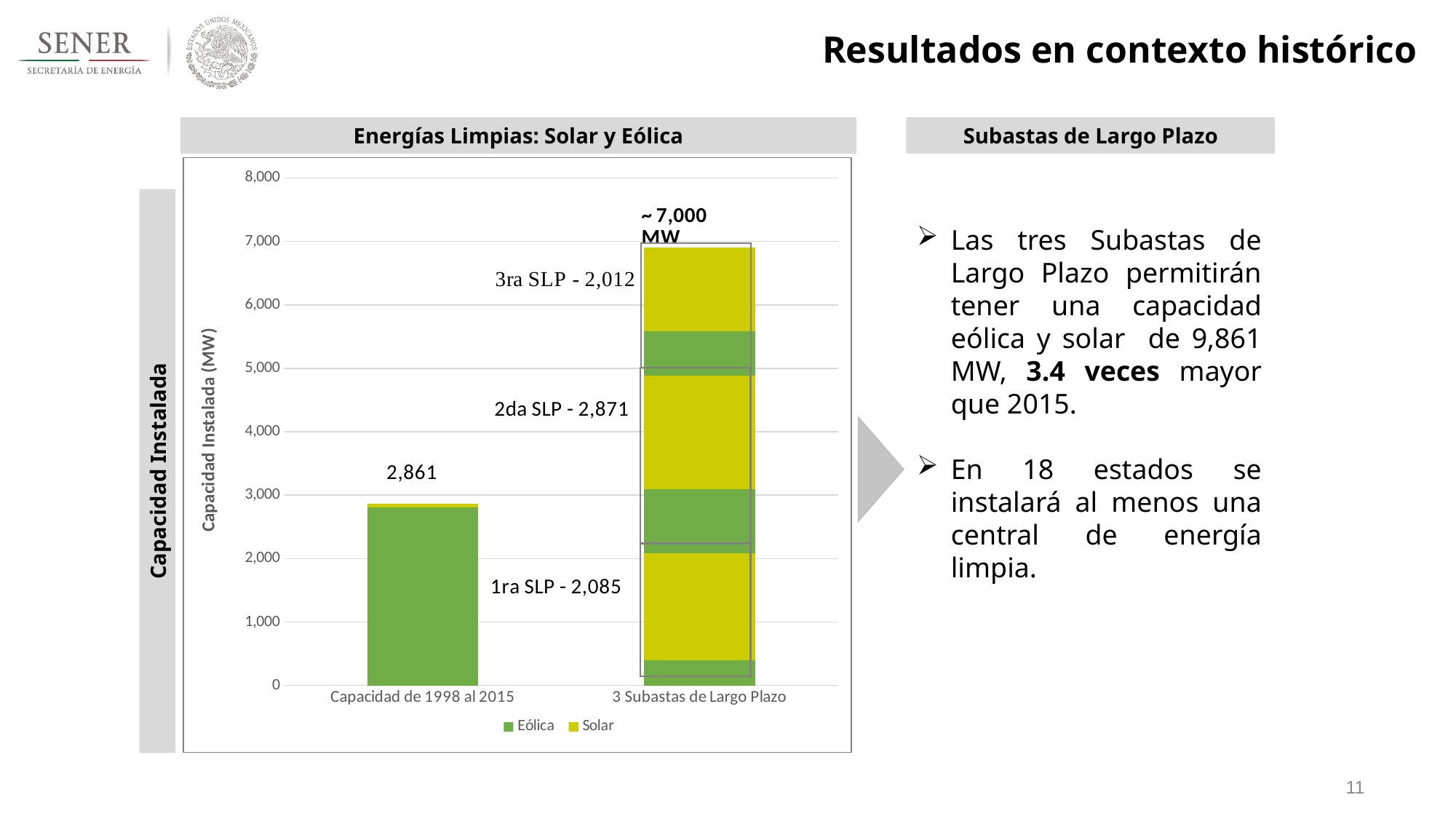
Which of the three SLP segments has the smallest value? 3ra SLP What value is given for '3ra SLP' in the '3 Subastas de Largo Plazo' bar? 2,012 What value is given for '2da SLP' in the '3 Subastas de Largo Plazo' bar? 2,871 Is the total height of the '3 Subastas de Largo Plazo' bar greater or less than 6,000? greater How many categories are shown on the x axis? 2 What is the value labelled on the bar for 'Capacidad de 1998 al 2015'? 2,861 How many series does the legend list? 2 What is the difference between the 2da SLP value and the 1ra SLP value? 786 Which bar is taller, 'Capacidad de 1998 al 2015' or '3 Subastas de Largo Plazo'? 3 Subastas de Largo Plazo Which of the three SLP segments has the largest value? 2da SLP What value is given for '1ra SLP' in the '3 Subastas de Largo Plazo' bar? 2,085 What kind of chart is shown on the slide? Stacked bar chart